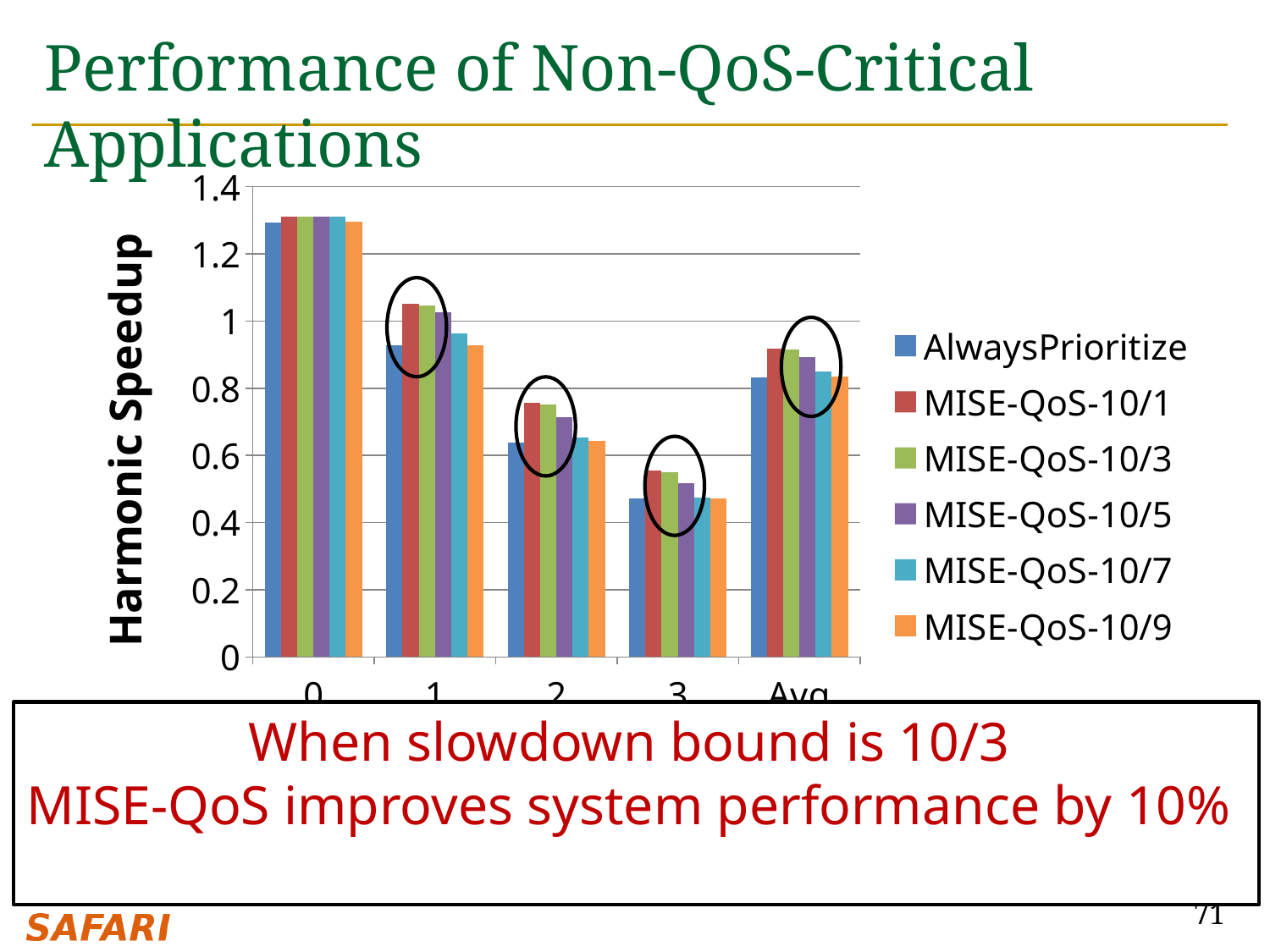
For category 2, which is larger: the MISE-QoS-10/1 value or the AlwaysPrioritize value? MISE-QoS-10/1 Is the AlwaysPrioritize value for category 3 greater or less than 0.6? less Is the MISE-QoS-10/9 value for category 2 greater or less than 0.8? less Which category has the highest AlwaysPrioritize value? 0 Is the AlwaysPrioritize value for category 0 greater or less than 1.2? greater What is the label of the y axis? Harmonic Speedup What kind of chart is shown on the slide? bar chart How many categories are shown along the x axis? 5 How many series does the legend list? 6 For the Avg category, which is larger: the MISE-QoS-10/3 value or the MISE-QoS-10/9 value? MISE-QoS-10/3 Which series is listed first in the legend? AlwaysPrioritize